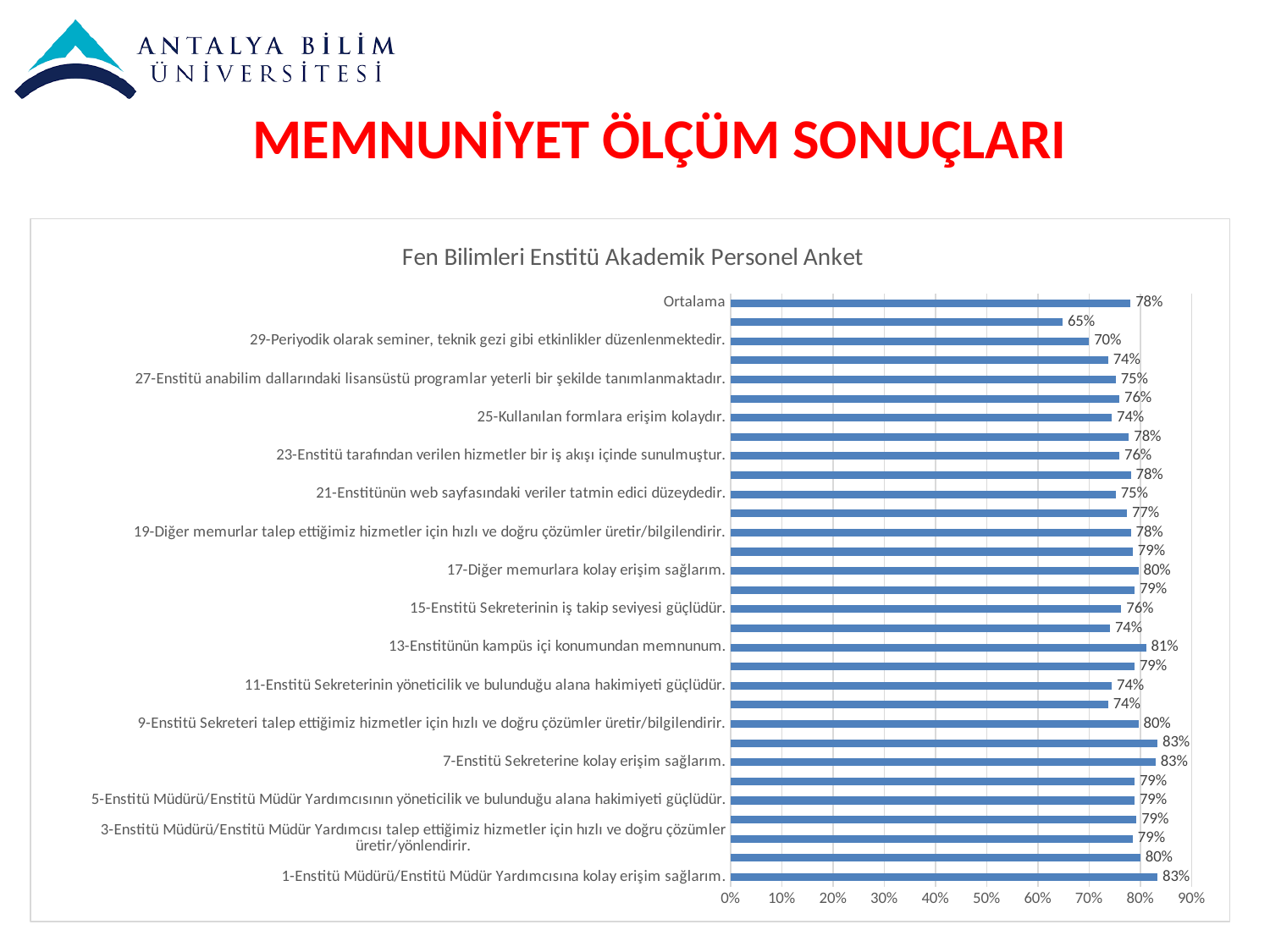
What is the value for item 17 (Diğer memurlara kolay erişim sağlarım)? 80% What kind of chart is shown on the slide? Bar chart What is the lowest value shown on the chart? 65% What is the value for item 1 (Enstitü Müdürü/Enstitü Müdür Yardımcısına kolay erişim sağlarım)? 83% What is the difference between the value for item 1 and the value for item 29? 13 percentage points How many bars are plotted on the chart, including Ortalama? 31 Is the value for item 11 (Enstitü Sekreterinin yöneticilik ve bulunduğu alana hakimiyeti güçlüdür) greater or less than 70%? greater What is the value for item 13 (Enstitünün kampüs içi konumundan memnunum)? 81% What is the title of the chart? Fen Bilimleri Enstitü Akademik Personel Anket What is the value for Ortalama? 78% What is the value for item 29 (Periyodik olarak seminer, teknik gezi gibi etkinlikler düzenlenmektedir)? 70% Which has a higher value: item 17 (Diğer memurlara kolay erişim sağlarım) or item 15 (Enstitü Sekreterinin iş takip seviyesi güçlüdür)? Item 17